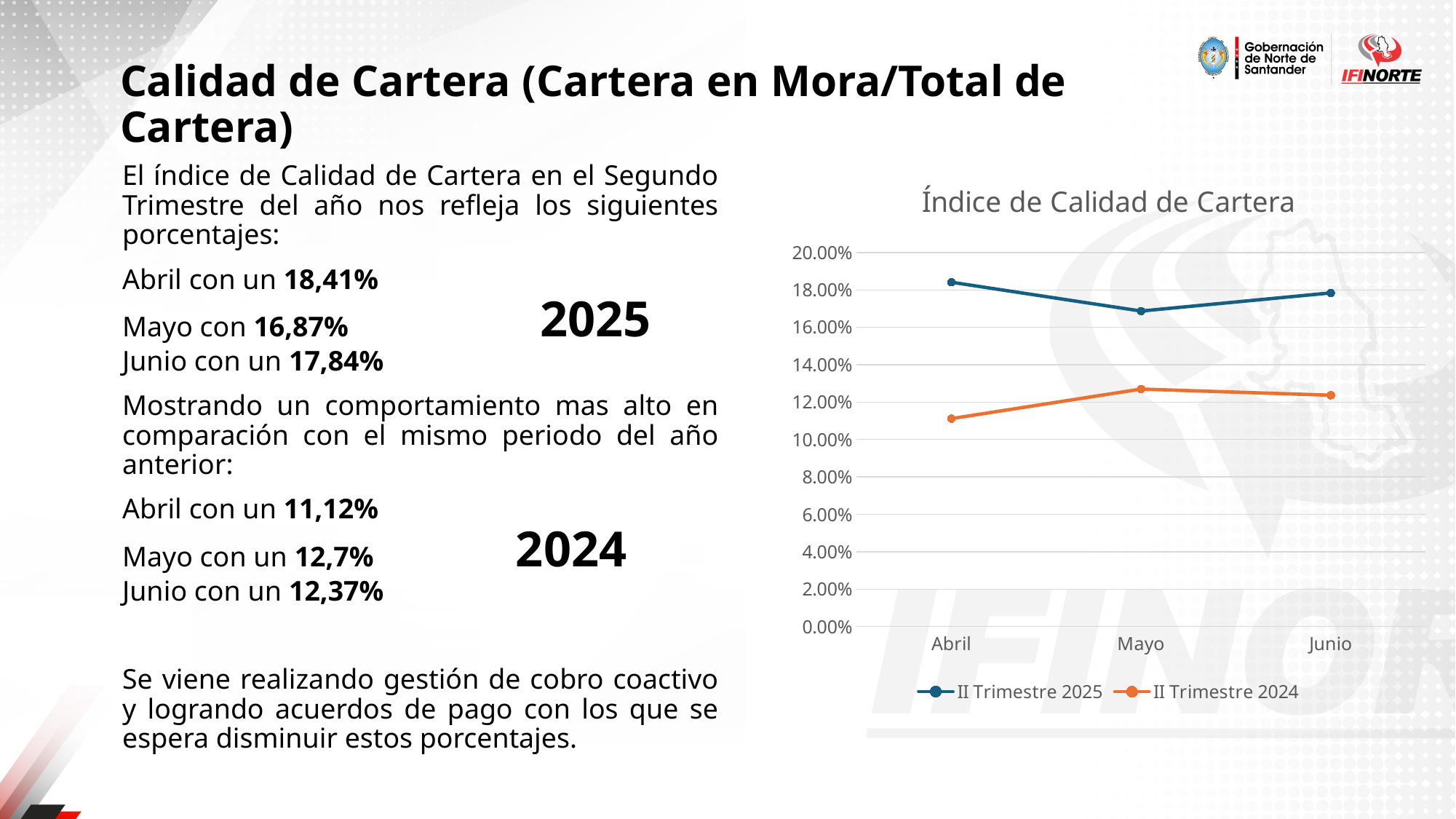
What is the value for Abril in the II Trimestre 2025 series? 18,41% Which month has the lowest value in the II Trimestre 2024 series? Abril Is the value for Abril in the II Trimestre 2024 series greater or less than 12.00%? less How many months are plotted along the x axis of the chart? 3 How many series does the chart legend list? 2 What is the value for Mayo in the II Trimestre 2024 series? 12,7% Which month has the highest value in the II Trimestre 2025 series? Abril What kind of chart is shown on the slide? line chart What is the difference between the Abril values of II Trimestre 2025 and II Trimestre 2024? 7,29% Which month has the lowest value in the II Trimestre 2025 series? Mayo What is the title of the chart? Índice de Calidad de Cartera For Junio, which series has the larger value, II Trimestre 2025 or II Trimestre 2024? II Trimestre 2025